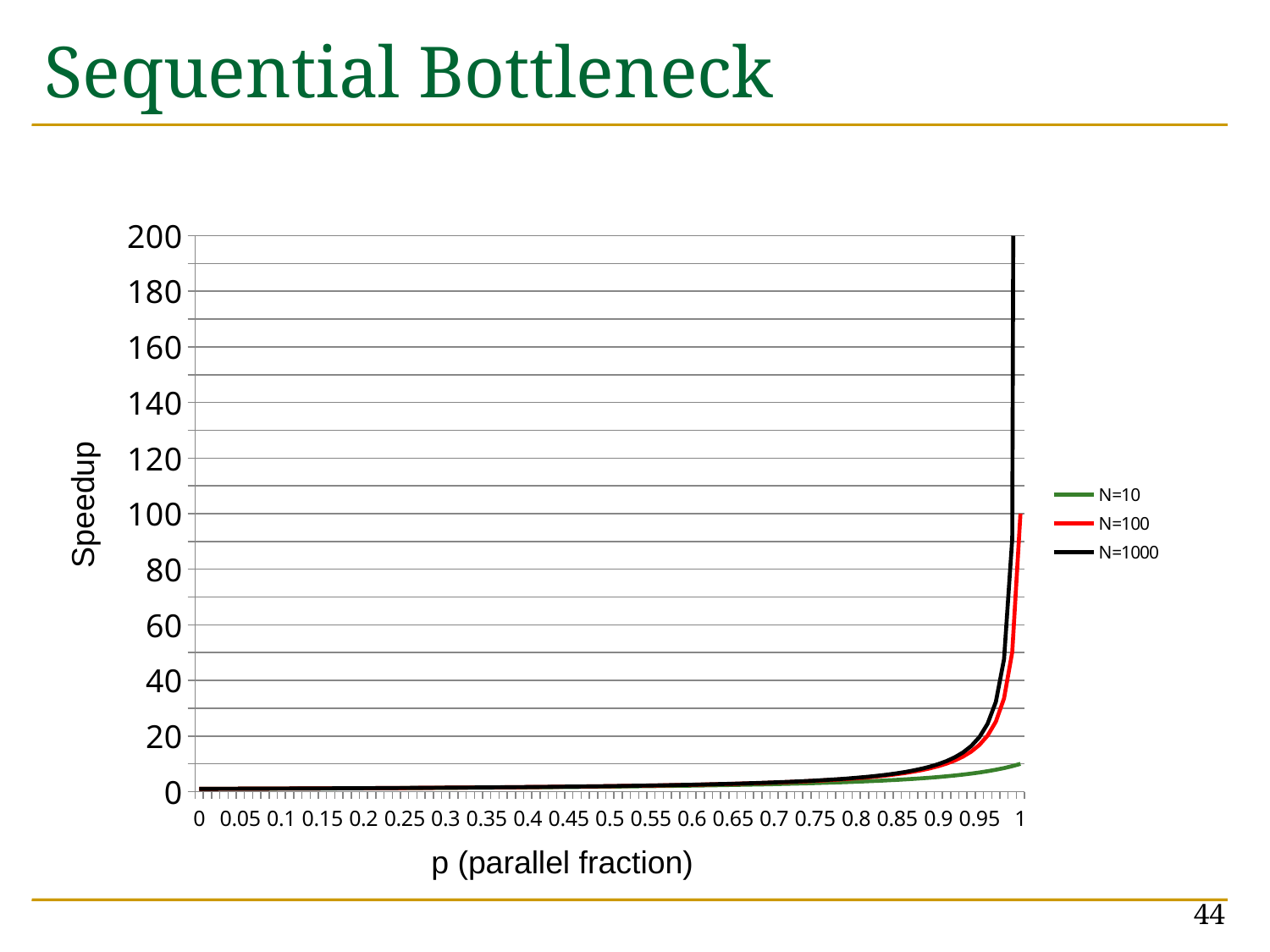
What is the label of the x axis? p (parallel fraction) Is the speedup for N=100 at p = 0.9 greater or less than 40? less Which series has the lowest speedup at p = 1? N=10 Do the speedup values rise or fall as p increases along the x axis? rise Which series is drawn in red? N=100 How many series does the legend list? 3 Is the speedup for N=1000 at p = 1 greater or less than 180? greater What kind of chart is shown on the slide? line chart Which series reaches the highest speedup on the chart? N=1000 At p = 1, which series has the larger speedup, N=100 or N=10? N=100 Is the speedup for N=10 at p = 1 greater or less than 20? less What is the label of the y axis? Speedup